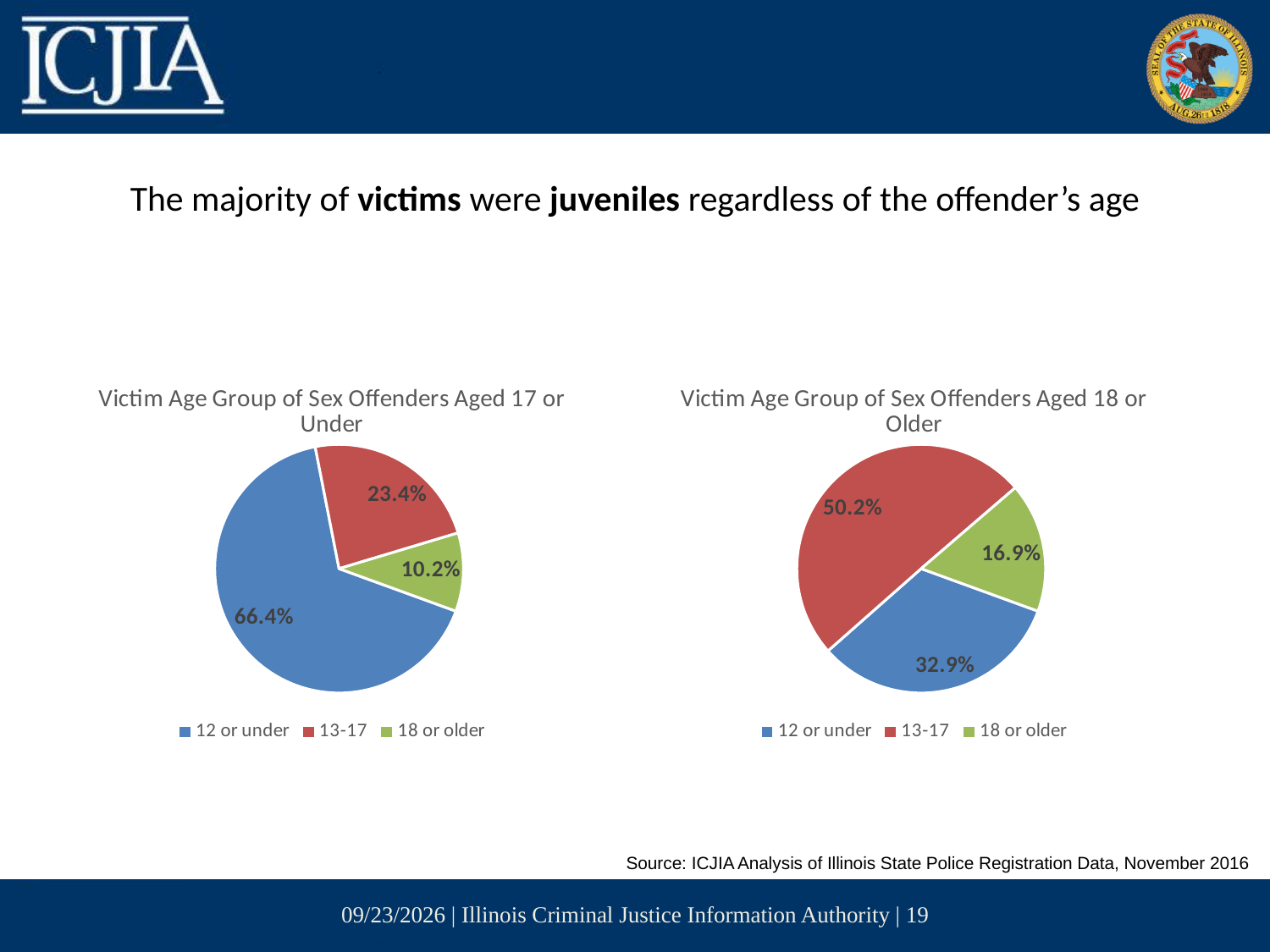
In the chart 'Victim Age Group of Sex Offenders Aged 17 or Under', which colour represents the 13-17 victim age group? Red Which chart shows a larger share of victims aged 12 or under: the one for offenders aged 17 or under, or the one for offenders aged 18 or older? Offenders aged 17 or under In the chart 'Victim Age Group of Sex Offenders Aged 18 or Older', what percentage of victims were 13-17? 50.2% In the chart 'Victim Age Group of Sex Offenders Aged 17 or Under', what percentage of victims were 12 or under? 66.4% In the chart 'Victim Age Group of Sex Offenders Aged 18 or Older', what percentage of victims were 18 or older? 16.9% How many slices does the chart 'Victim Age Group of Sex Offenders Aged 18 or Older' have? 3 In the chart 'Victim Age Group of Sex Offenders Aged 18 or Older', what is the difference in percentage points between the 12 or under and 18 or older slices? 16.0 What type of chart is 'Victim Age Group of Sex Offenders Aged 17 or Under'? Pie chart In the chart 'Victim Age Group of Sex Offenders Aged 17 or Under', which victim age group has the smallest share? 18 or older In the chart 'Victim Age Group of Sex Offenders Aged 17 or Under', what percentage of victims were 13-17? 23.4% In the chart 'Victim Age Group of Sex Offenders Aged 17 or Under', what is the difference in percentage points between the 12 or under and 13-17 slices? 43.0 In the chart 'Victim Age Group of Sex Offenders Aged 18 or Older', which victim age group has the largest share? 13-17